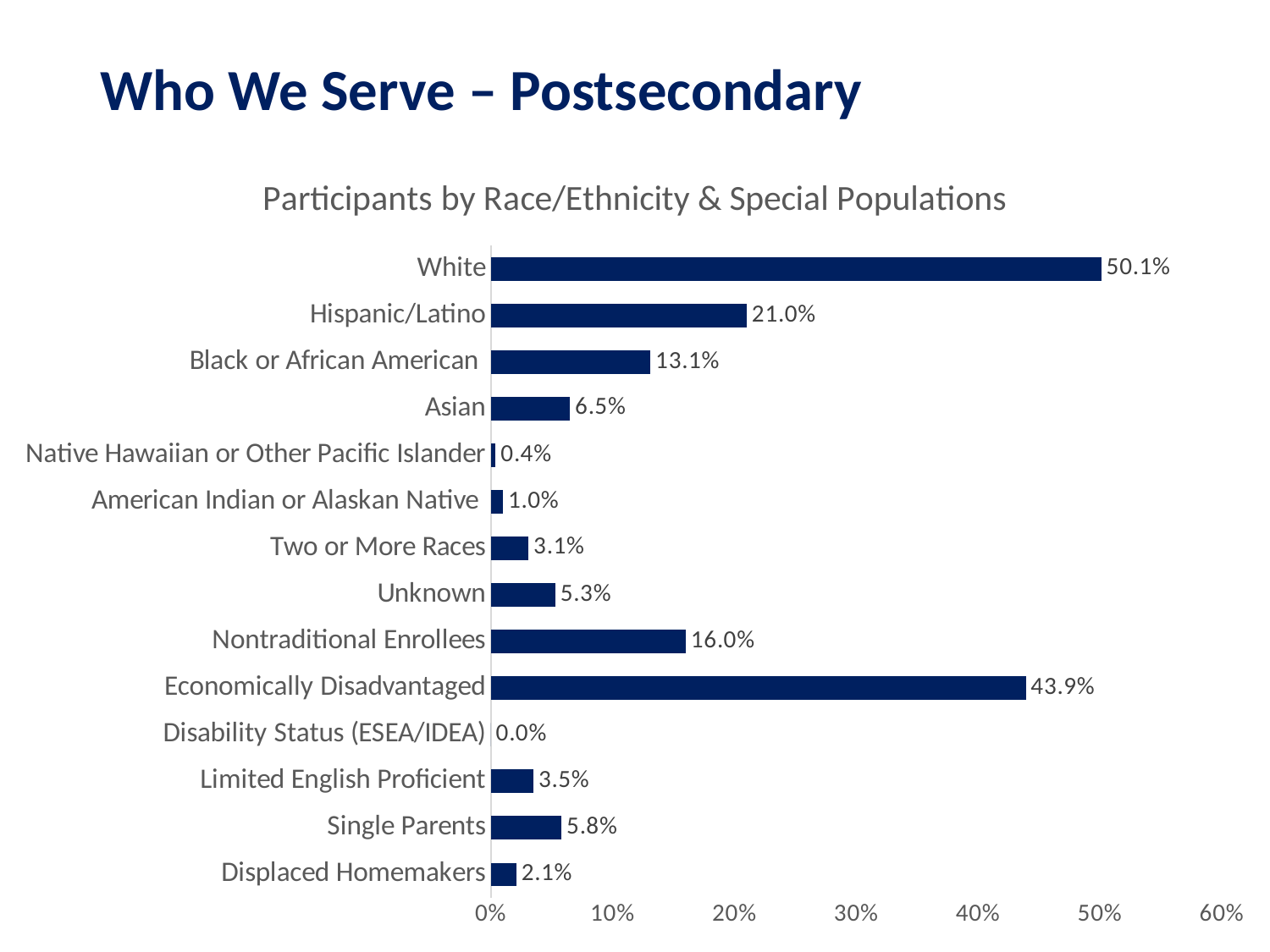
Which is larger, the value for Single Parents or the value for Asian? Asian Which category has the highest value? White What is the value for Nontraditional Enrollees? 16.0% Is the value for Black or African American greater or less than 10%? greater What kind of chart is shown on the slide? Bar chart Which category has the lowest value? Disability Status (ESEA/IDEA) What is the value for Native Hawaiian or Other Pacific Islander? 0.4% What is the title of the chart? Participants by Race/Ethnicity & Special Populations What is the difference between the values for White and Hispanic/Latino? 29.1% What is the value for Economically Disadvantaged? 43.9% What is the value for White? 50.1% How many categories are shown in the chart? 14